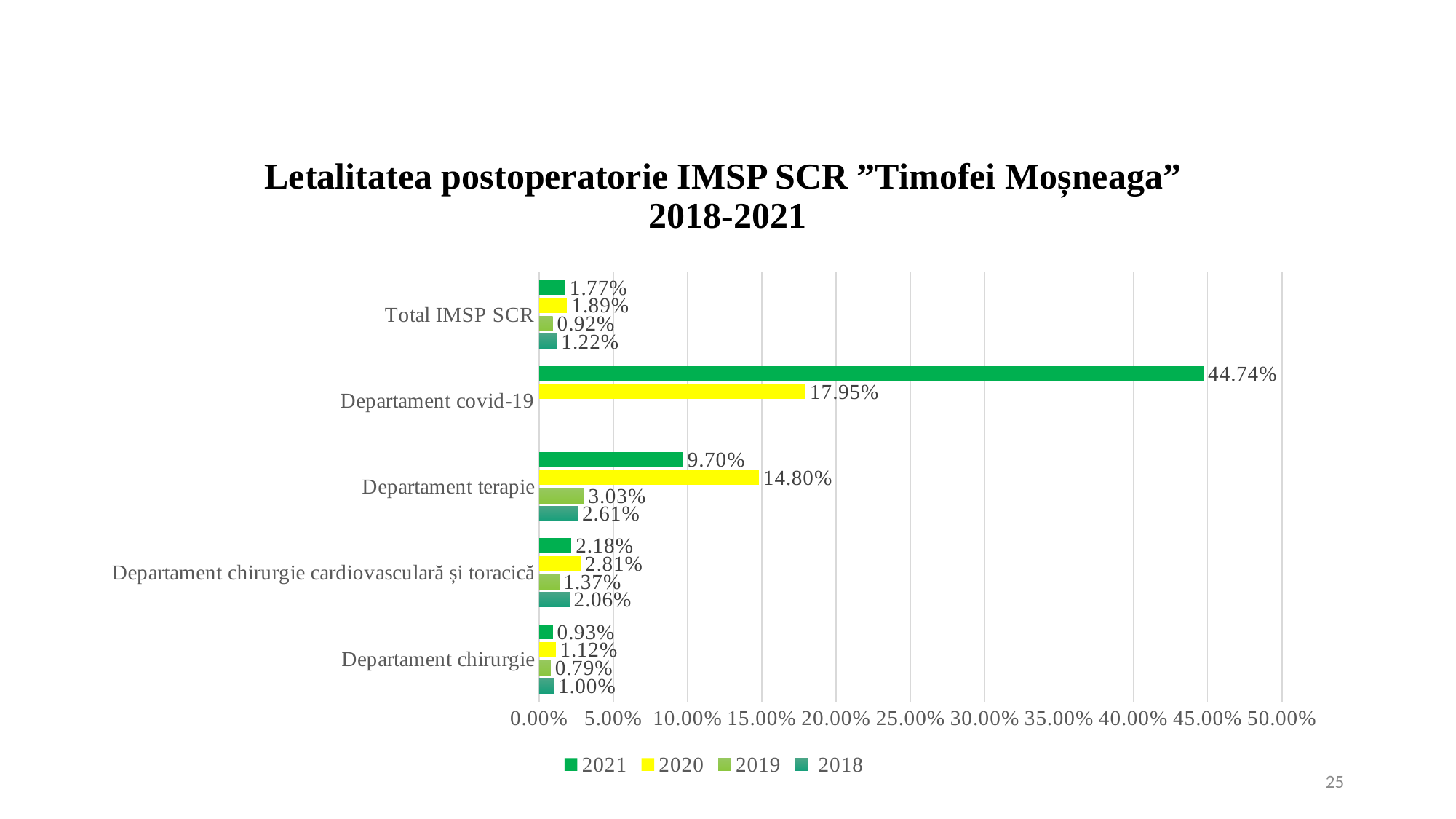
Which category has the highest value in 2021? Departament covid-19 What is the value for Departament covid-19 in 2021? 44.74% How many categories are shown on the y axis? 5 What is the value for Total IMSP SCR in 2019? 0.92% Which is larger for Departament chirurgie cardiovasculară și toracică: the 2020 value or the 2021 value? 2020 What kind of chart is shown on the slide? Bar chart What is the value for Departament chirurgie in 2018? 1.00% What is the value for Departament terapie in 2020? 14.80% How many series does the legend list? 4 What is the difference between the 2021 and 2020 values for Departament covid-19? 26.79% What is the title of the chart? Letalitatea postoperatorie IMSP SCR ”Timofei Moșneaga” 2018-2021 Which category has the lowest value in 2020? Departament chirurgie